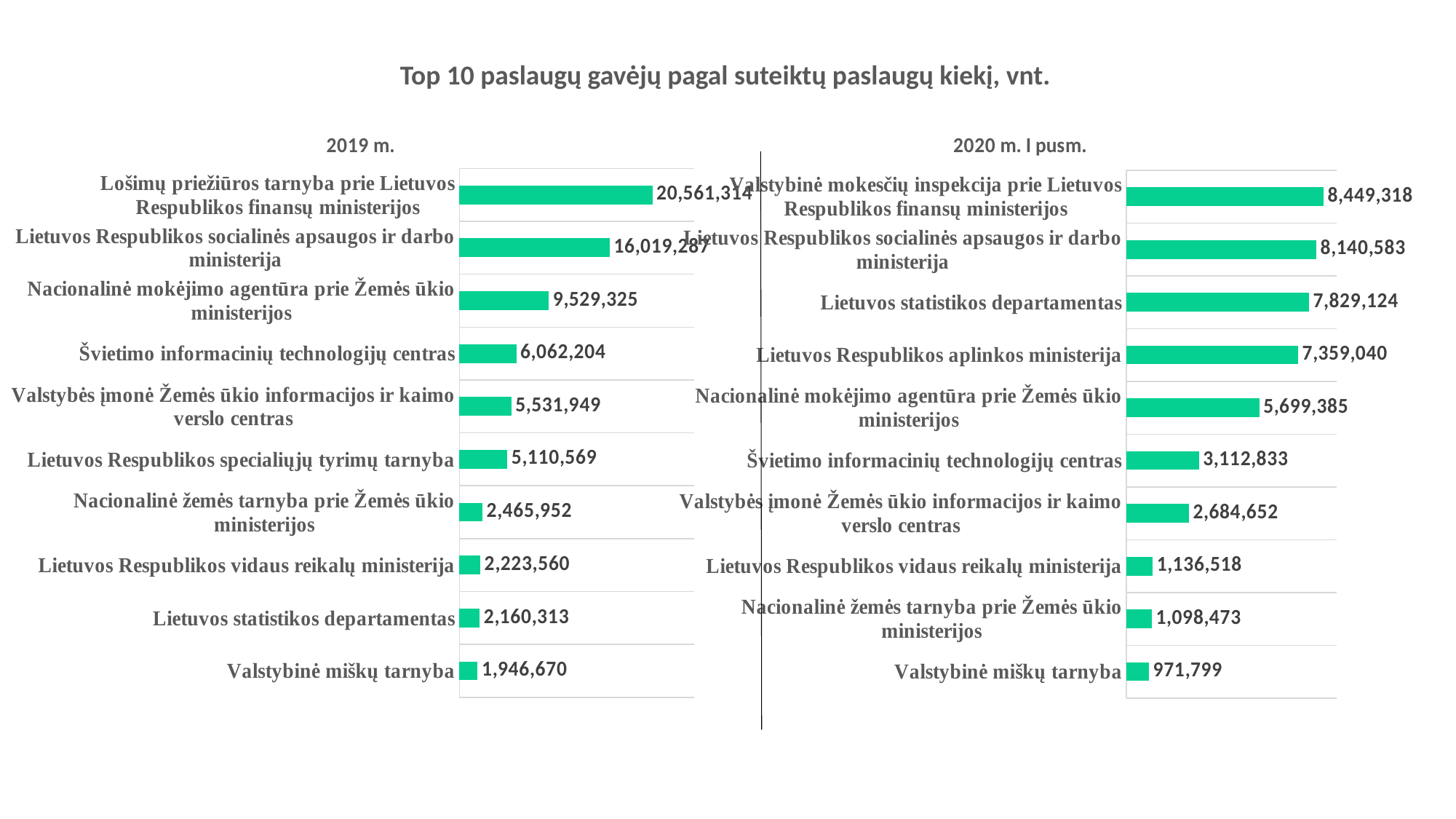
What kind of chart is the 2020 m. I pusm. chart? Bar chart How many categories are shown in the 2019 m. chart? 10 In the 2020 m. I pusm. chart, what is the difference between the values for Valstybinė mokesčių inspekcija prie Lietuvos Respublikos finansų ministerijos and Lietuvos Respublikos socialinės apsaugos ir darbo ministerija? 308,735 In the 2020 m. I pusm. chart, which category has the highest value? Valstybinė mokesčių inspekcija prie Lietuvos Respublikos finansų ministerijos In the 2020 m. I pusm. chart, what is the value for Lietuvos statistikos departamentas? 7,829,124 In the 2019 m. chart, what is the value for Lošimų priežiūros tarnyba prie Lietuvos Respublikos finansų ministerijos? 20,561,314 In the 2020 m. I pusm. chart, which is larger: the value for Lietuvos Respublikos vidaus reikalų ministerija or the value for Valstybinė miškų tarnyba? Lietuvos Respublikos vidaus reikalų ministerija In the 2019 m. chart, what is the difference between the values for Lošimų priežiūros tarnyba prie Lietuvos Respublikos finansų ministerijos and Lietuvos Respublikos socialinės apsaugos ir darbo ministerija? 4,542,027 In the 2019 m. chart, which category has the lowest value? Valstybinė miškų tarnyba In the 2019 m. chart, what is the value for Lietuvos statistikos departamentas? 2,160,313 In the 2019 m. chart, which is larger: the value for Švietimo informacinių technologijų centras or the value for Lietuvos Respublikos specialiųjų tyrimų tarnyba? Švietimo informacinių technologijų centras What is the title of the slide's chart section? Top 10 paslaugų gavėjų pagal suteiktų paslaugų kiekį, vnt.